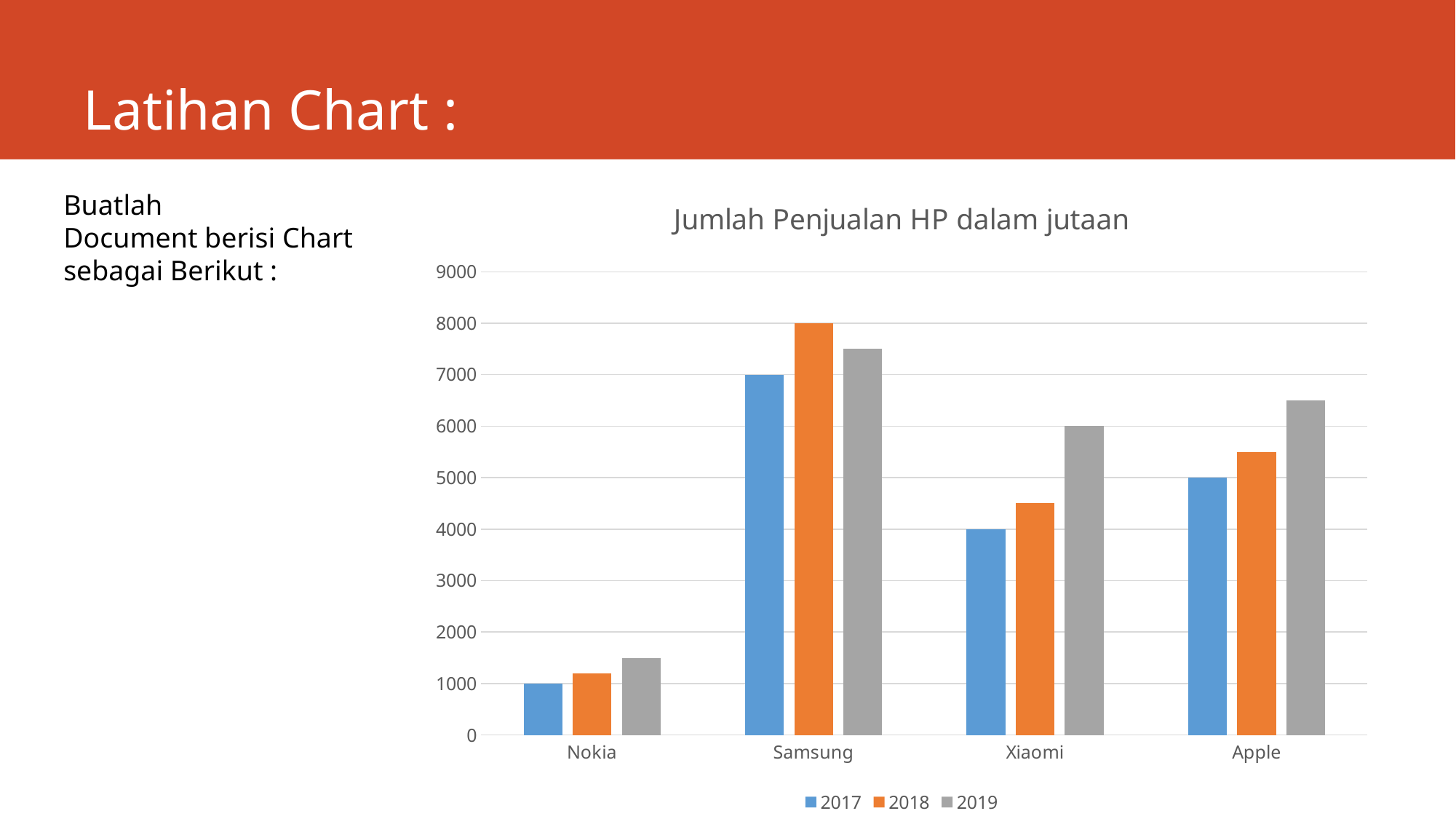
What is the value for Nokia in 2017? 1000 What is the value for Samsung in 2018? 8000 Which category has the highest value in 2017? Samsung Which is larger, the 2019 value for Xiaomi or the 2019 value for Apple? Apple What type of chart is shown on the slide? Bar chart Which category has the lowest value in 2019? Nokia How many series does the legend list? 3 How many categories are shown on the x axis? 4 What is the value for Xiaomi in 2019? 6000 What is the title of the chart? Jumlah Penjualan HP dalam jutaan Is the value for Apple in 2019 greater or less than 6000? greater What is the difference between Samsung's 2018 value and Samsung's 2017 value? 1000